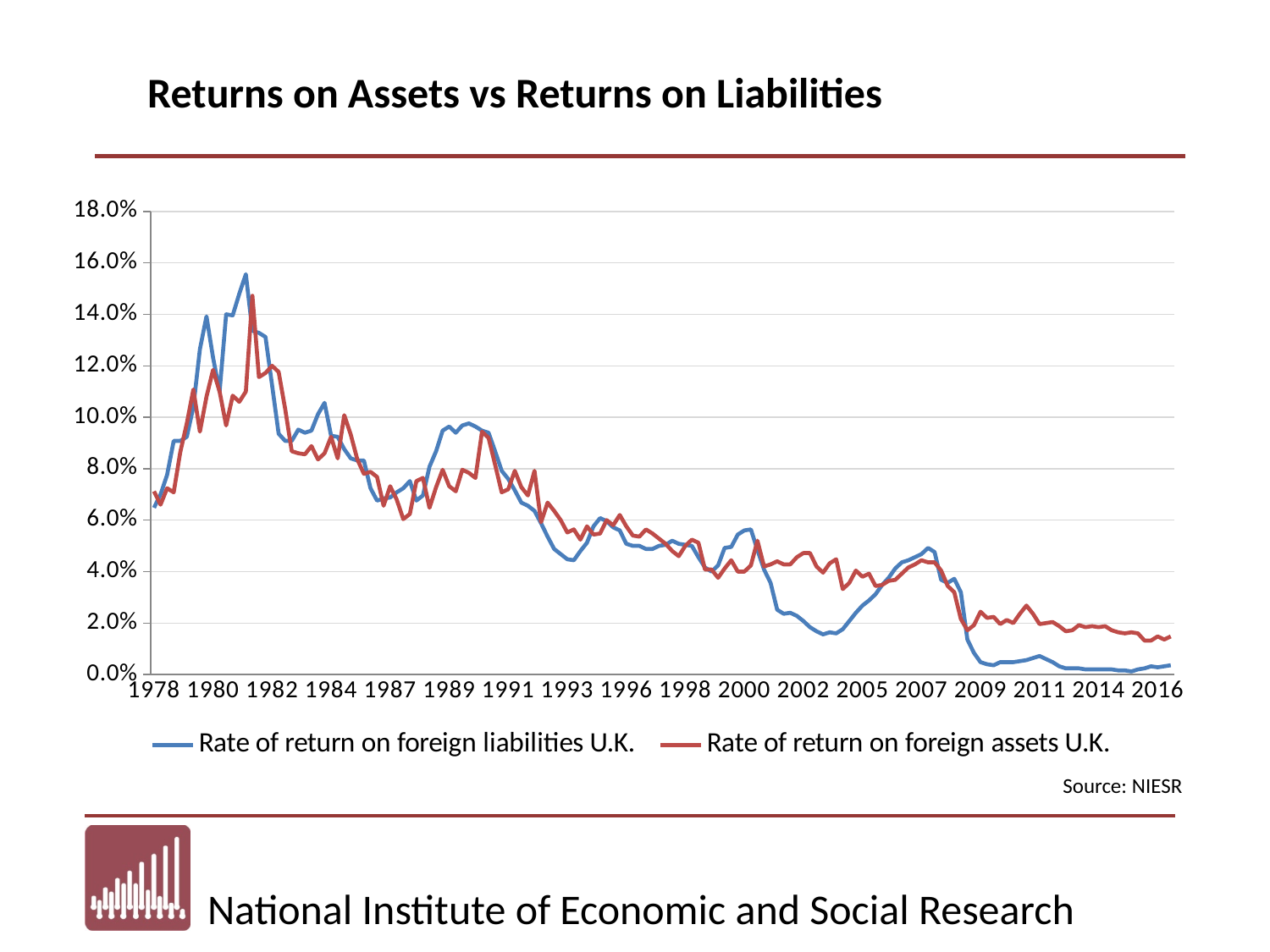
What is the title of the chart? Returns on Assets vs Returns on Liabilities In 2016, which series is higher: rate of return on foreign liabilities U.K. or rate of return on foreign assets U.K.? Rate of return on foreign assets U.K. Around 1989, which series is higher: rate of return on foreign liabilities U.K. or rate of return on foreign assets U.K.? Rate of return on foreign liabilities U.K. What kind of chart is shown on the slide? Line chart Which series is drawn in red? Rate of return on foreign assets U.K. Is the rate of return on foreign liabilities U.K. in 2016 greater or less than 2.0%? less Overall, do the rates of return rise or fall from 1978 to 2016? Fall Is the peak value of the rate of return on foreign liabilities U.K. greater or less than 14.0%? greater How many series does the legend list? 2 Around 2002 to 2004, which series is higher: rate of return on foreign liabilities U.K. or rate of return on foreign assets U.K.? Rate of return on foreign assets U.K.